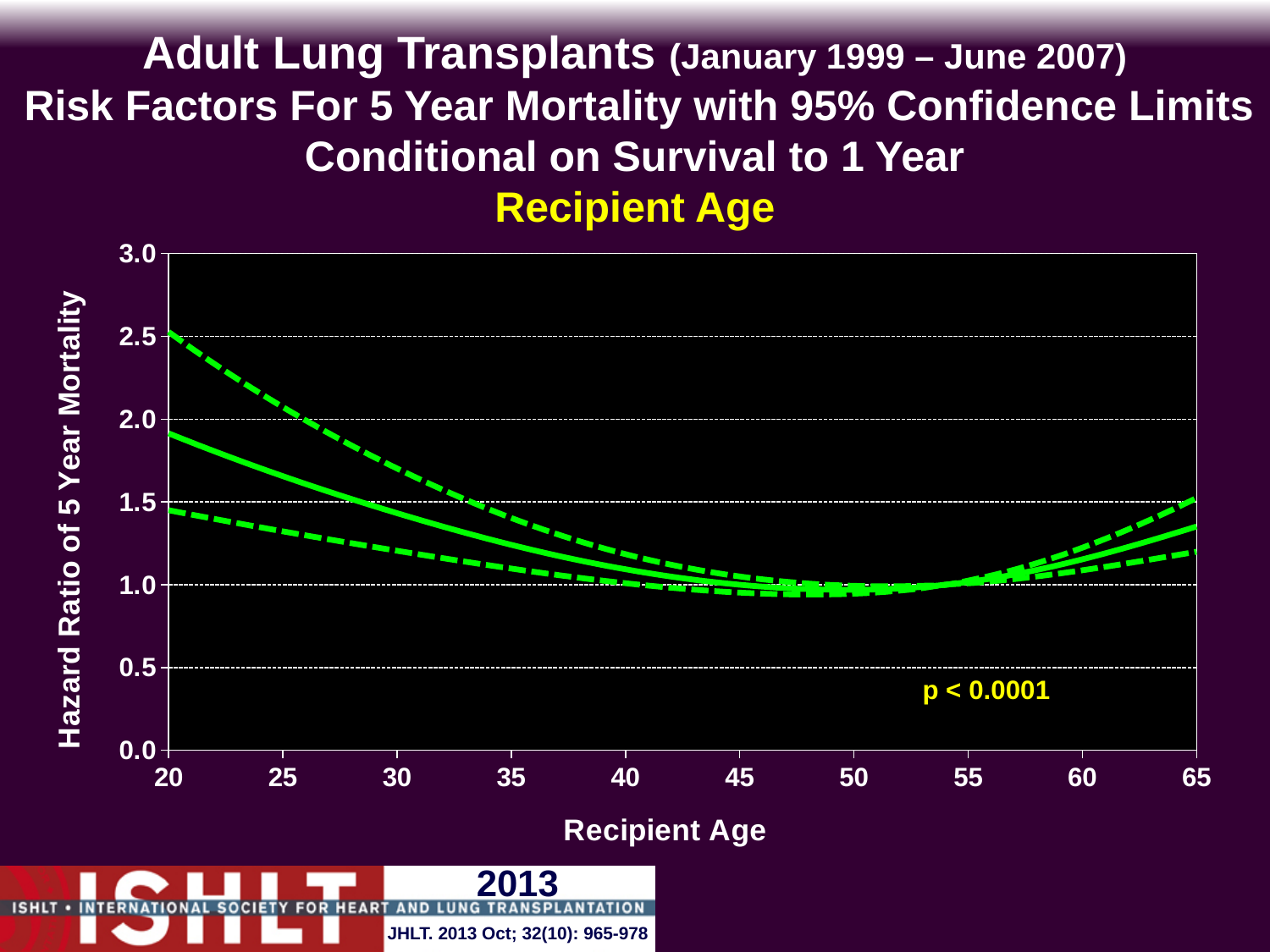
Is the hazard ratio on the solid line at recipient age 20 greater or less than 1.5? greater What is the label of the y axis? Hazard Ratio of 5 Year Mortality Is the hazard ratio on the solid line at recipient age 40 greater or less than 1.5? less How many lines are plotted on the chart? 3 What p-value is printed on the chart? p < 0.0001 What kind of chart is shown on the slide? line chart Is the hazard ratio at recipient age 20 larger or smaller than at recipient age 65 on the solid line? larger Does the solid hazard ratio line rise or fall as recipient age increases from 55 to 65? rise Is the hazard ratio on the solid line at recipient age 65 greater or less than 1.5? less Does the solid hazard ratio line rise or fall as recipient age increases from 20 to 45? fall